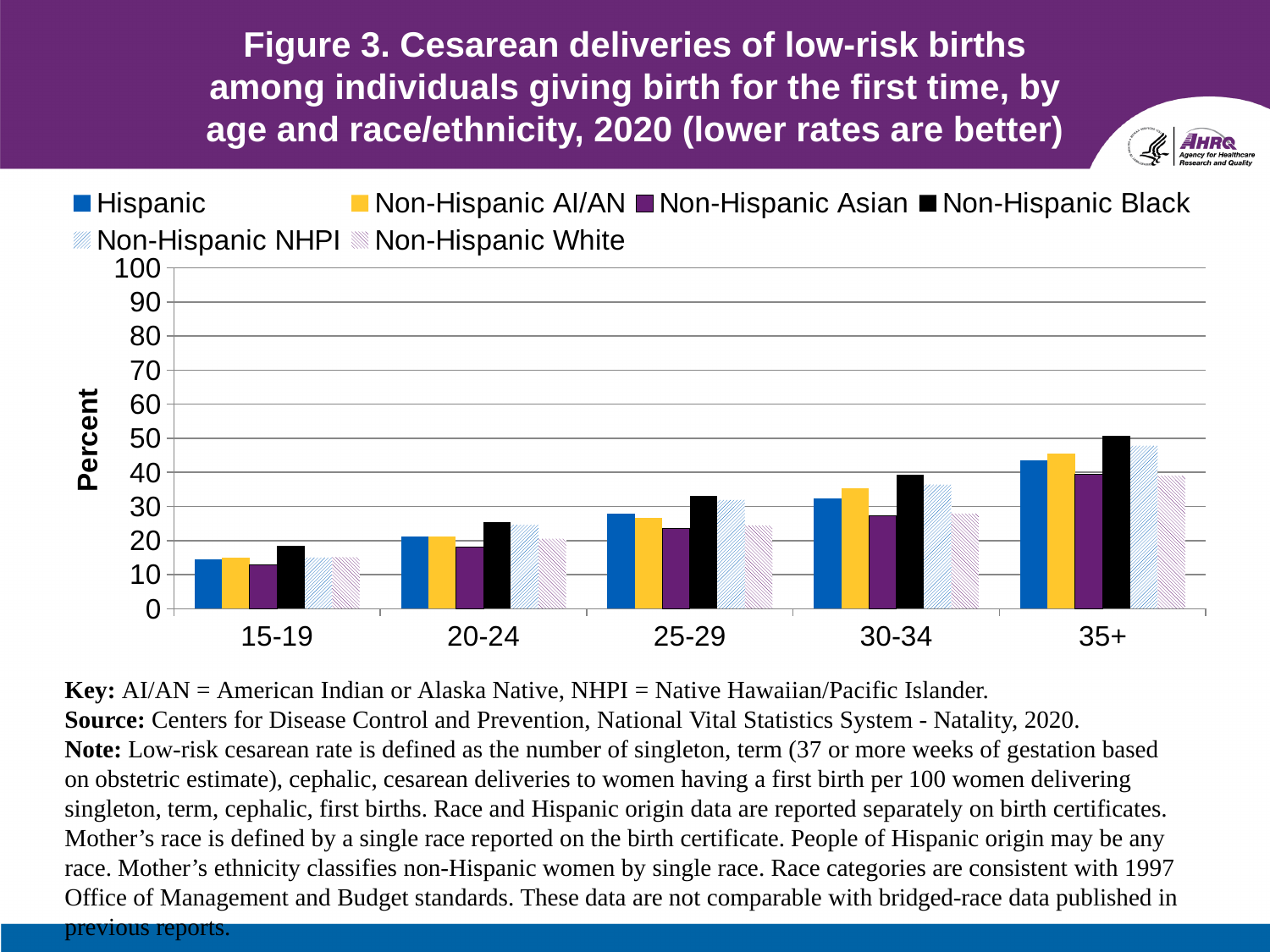
How many age groups are shown on the x axis? 5 Is the value for Hispanic in the 35+ age group greater or less than 40? greater Is the value for Non-Hispanic White in the 15-19 age group greater or less than 20? less Which age group has the lowest value for Non-Hispanic Asian? 15-19 Do the values for Non-Hispanic Black rise or fall as age increases along the x axis? Rise Which age group has the highest value for Non-Hispanic Black? 35+ In the 35+ age group, which is larger: Non-Hispanic NHPI or Non-Hispanic White? Non-Hispanic NHPI What is the label on the y axis of the chart? Percent What kind of chart is shown on the slide? Bar chart How many series does the legend list? 6 In the 25-29 age group, which is larger: Non-Hispanic Black or Non-Hispanic Asian? Non-Hispanic Black Which race/ethnicity group has the highest value in the 15-19 age group? Non-Hispanic Black